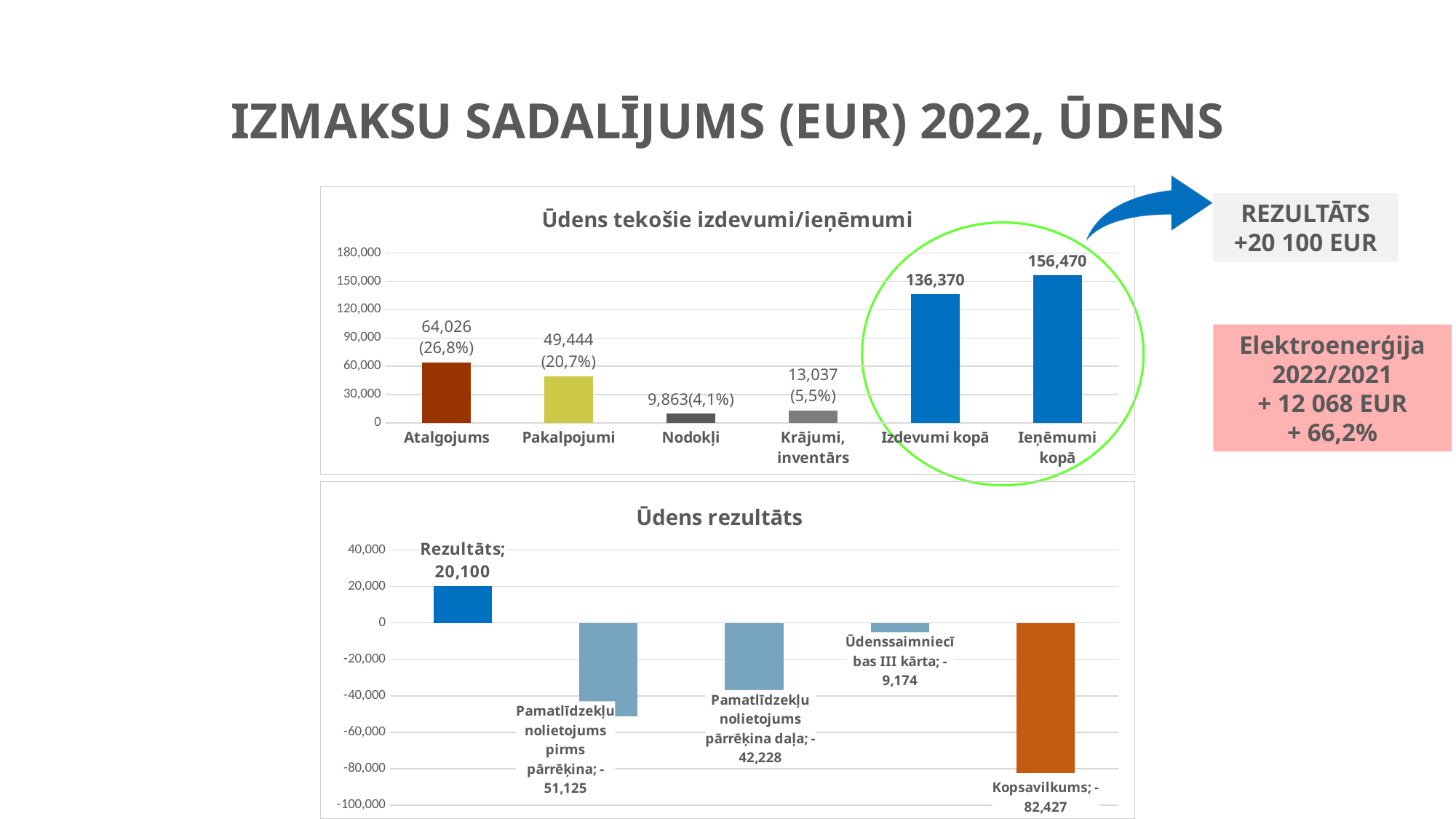
In the chart titled "Ūdens tekošie izdevumi/ieņēmumi", what is the value for Atalgojums? 64,026 In the chart titled "Ūdens tekošie izdevumi/ieņēmumi", what is the value for Ieņēmumi kopā? 156,470 In the chart titled "Ūdens rezultāts", what is the value for Kopsavilkums? -82,427 In the chart titled "Ūdens tekošie izdevumi/ieņēmumi", which category has the highest value? Ieņēmumi kopā In the chart titled "Ūdens tekošie izdevumi/ieņēmumi", what percentage is shown for Pakalpojumi? 20,7% In the chart titled "Ūdens rezultāts", which category has the lowest value? Kopsavilkums How many categories are shown in the chart titled "Ūdens tekošie izdevumi/ieņēmumi"? 6 In the chart titled "Ūdens rezultāts", what is the value for Rezultāts? 20,100 In the chart titled "Ūdens tekošie izdevumi/ieņēmumi", which is larger: Krājumi, inventārs or Nodokļi? Krājumi, inventārs In the chart titled "Ūdens tekošie izdevumi/ieņēmumi", what is the difference between Ieņēmumi kopā and Izdevumi kopā? 20,100 What type of chart is the chart titled "Ūdens rezultāts"? Bar chart In the chart titled "Ūdens tekošie izdevumi/ieņēmumi", which category has the lowest value? Nodokļi